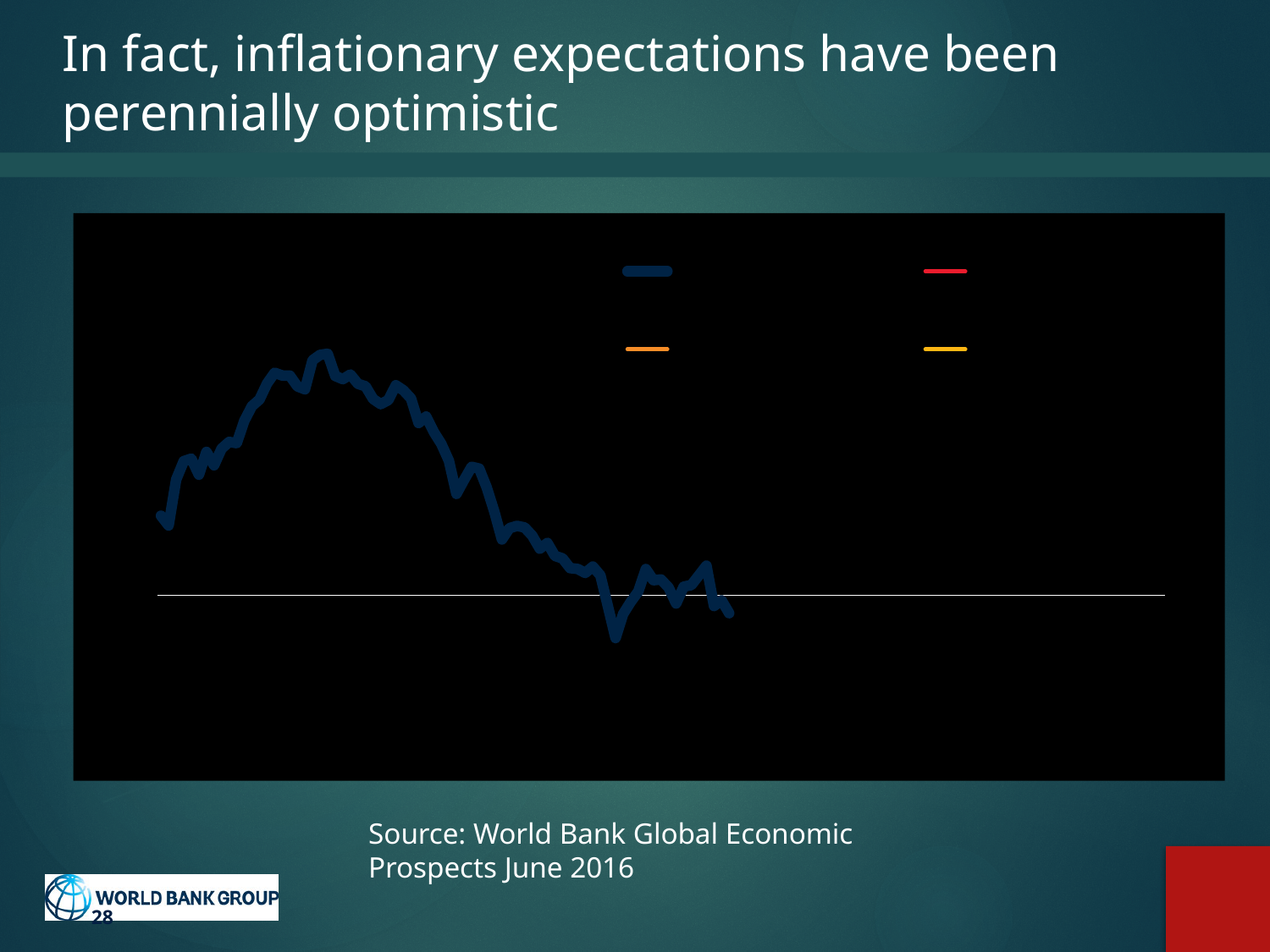
What kind of chart is shown on the slide? line chart What source is cited below the chart? World Bank Global Economic Prospects June 2016 How many series does the legend list? 4 How many lines are actually plotted on the chart? 1 Over the right half of the chart, does the plotted line generally rise or fall? fall Does the plotted line end higher or lower than where it starts on the left? lower What colour is the line plotted on the chart? dark blue